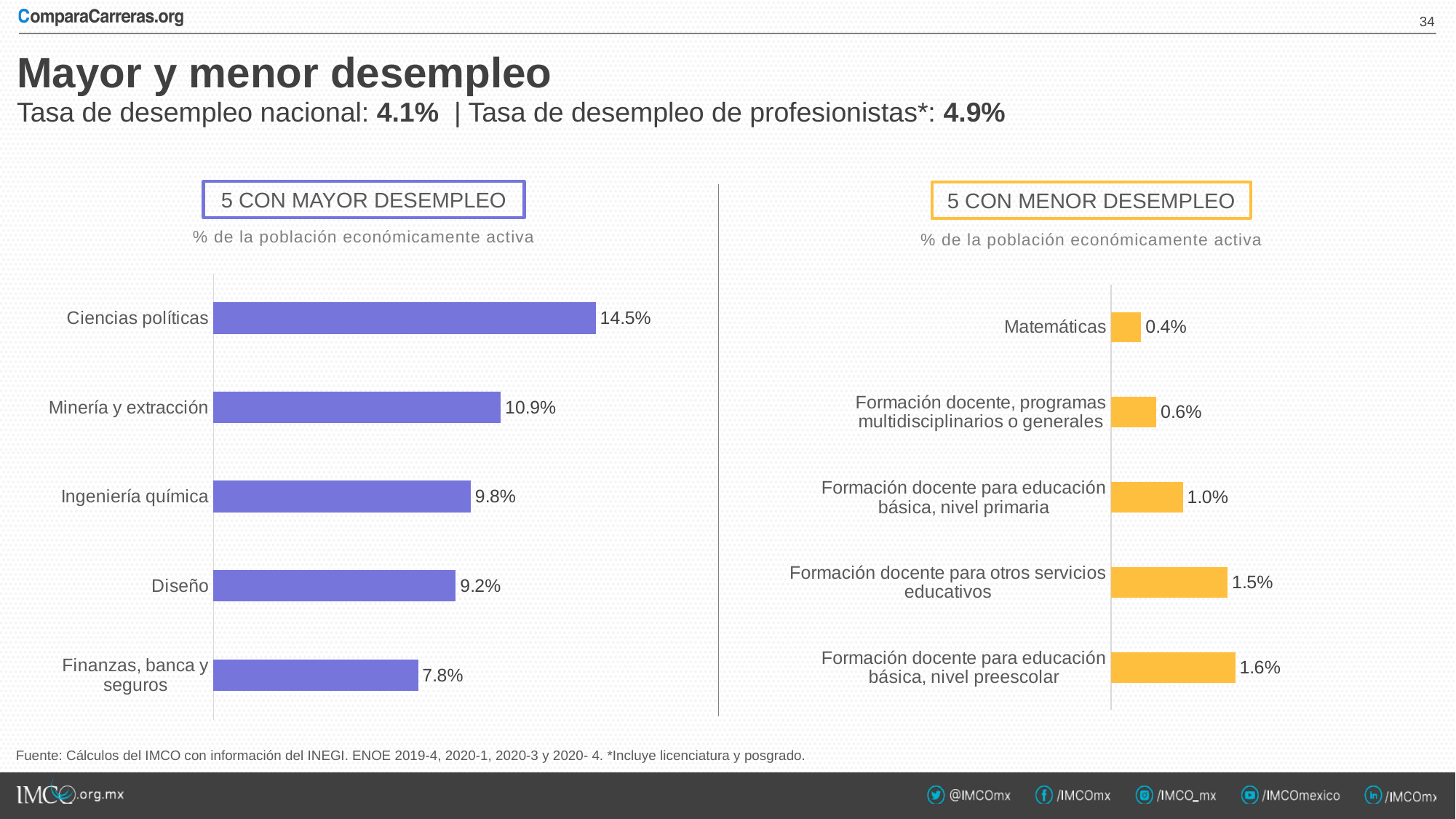
What colour are the bars in the '5 CON MENOR DESEMPLEO' chart? Yellow/orange In the '5 CON MAYOR DESEMPLEO' chart, which is larger: Ingeniería química or Diseño? Ingeniería química In the '5 CON MENOR DESEMPLEO' chart, what is the value for Matemáticas? 0.4% In the '5 CON MENOR DESEMPLEO' chart, which category has the highest value? Formación docente para educación básica, nivel preescolar In the '5 CON MENOR DESEMPLEO' chart, what is the value for Formación docente para otros servicios educativos? 1.5% In the '5 CON MAYOR DESEMPLEO' chart, what is the value for Diseño? 9.2% In the '5 CON MAYOR DESEMPLEO' chart, which category has the lowest value? Finanzas, banca y seguros In the '5 CON MENOR DESEMPLEO' chart, what is the difference between Formación docente para educación básica, nivel preescolar and Matemáticas? 1.2% How many categories are shown in the '5 CON MENOR DESEMPLEO' chart? 5 In the '5 CON MAYOR DESEMPLEO' chart, what is the value for Ciencias políticas? 14.5% In the '5 CON MAYOR DESEMPLEO' chart, what is the difference between Ciencias políticas and Minería y extracción? 3.6% What type of chart is the '5 CON MAYOR DESEMPLEO' chart? Bar chart